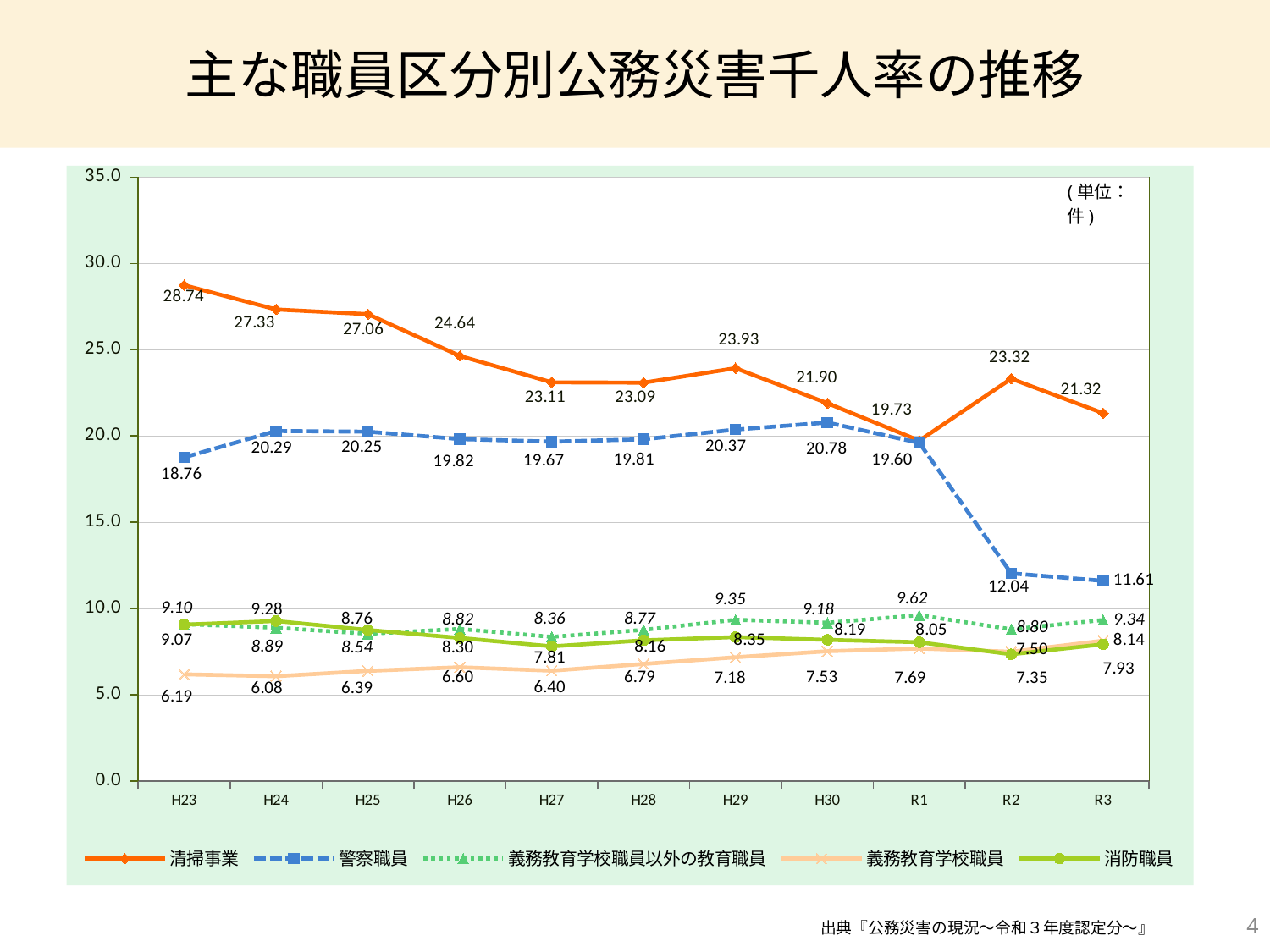
What is the value for 警察職員 in R3? 11.61 What is the value for 義務教育学校職員 in H23? 6.19 What is the difference between the 警察職員 values in R1 and R2? 7.56 In which year is the value for 警察職員 lowest? R3 In H30, which is larger: 清掃事業 or 警察職員? 清掃事業 In which year is the value for 清掃事業 highest? H23 How many series does the legend list? 5 How many years are plotted on the x axis? 11 What is the difference between the 清掃事業 values in H23 and R3? 7.42 What kind of chart is shown on the slide? line chart What is the value for 清掃事業 in H23? 28.74 Does the value for 義務教育学校職員 generally rise or fall from H23 to R3? rise